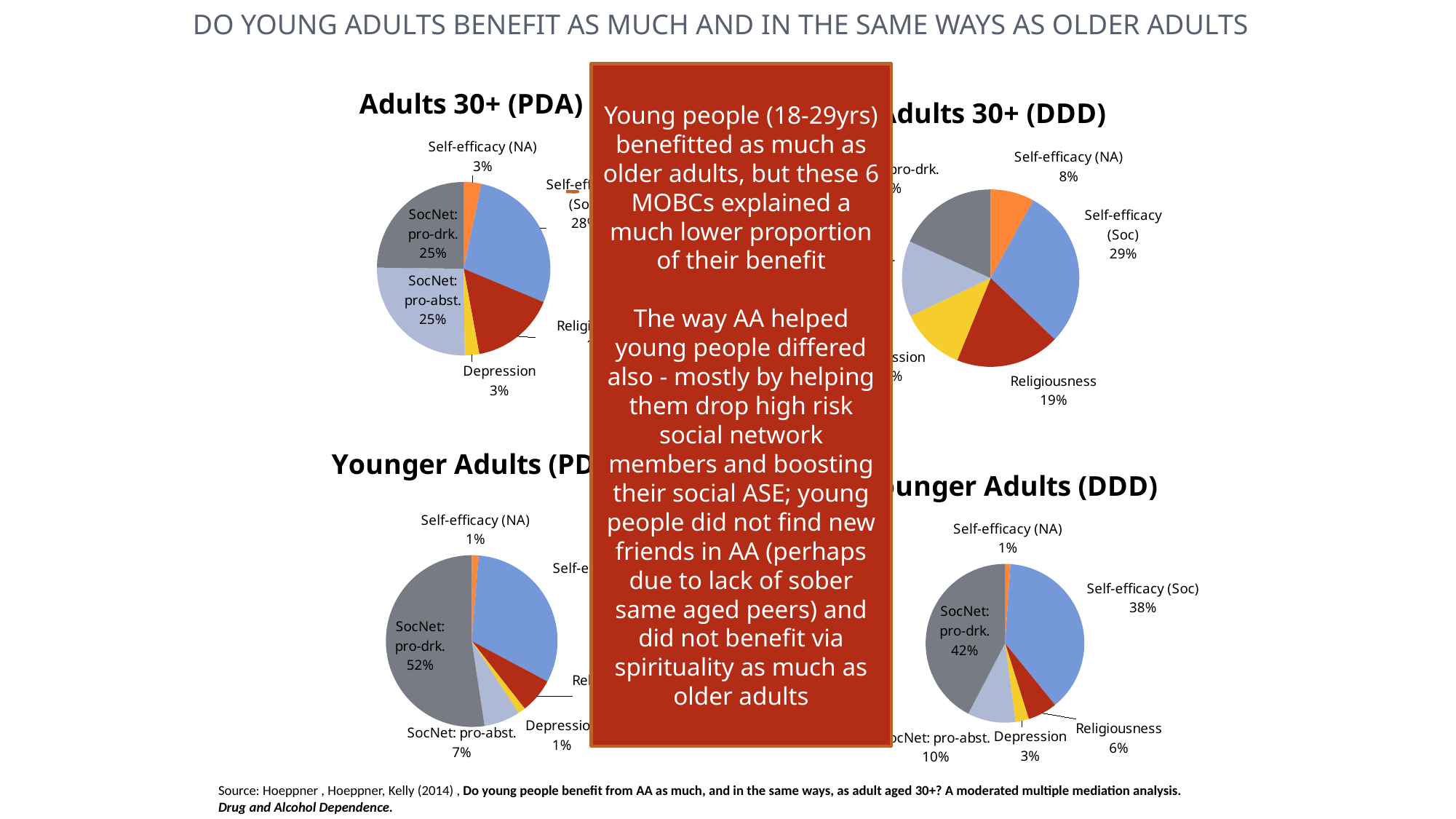
In the Younger Adults (PDA) pie chart (bottom left), what share is labelled for SocNet: pro-abst.? 7% In the Younger Adults (DDD) pie chart (bottom right), what is the difference in percentage points between SocNet: pro-drk. and SocNet: pro-abst.? 32 percentage points In the Younger Adults (PDA) pie chart (bottom left), what percentage is shown for SocNet: pro-drk.? 52% What type of chart is used on this slide? Pie chart In the Adults 30+ (PDA) pie chart (top left), what share is labelled for Self-efficacy (NA)? 3% In the Adults 30+ (PDA) pie chart (top left), what percentage is shown for SocNet: pro-drk.? 25% In the Younger Adults (DDD) pie chart (bottom right), which category has the largest slice? SocNet: pro-drk. In the Younger Adults (DDD) pie chart (bottom right), which is larger: Religiousness or Depression? Religiousness In the Younger Adults (DDD) pie chart (bottom right), what percentage is shown for Self-efficacy (Soc)? 38% In the Adults 30+ (DDD) pie chart (top right), what share is labelled for Self-efficacy (Soc)? 29% In the Adults 30+ (DDD) pie chart (top right), what percentage is shown for Religiousness? 19% In the Adults 30+ (DDD) pie chart (top right), what percentage is shown for Self-efficacy (NA)? 8%